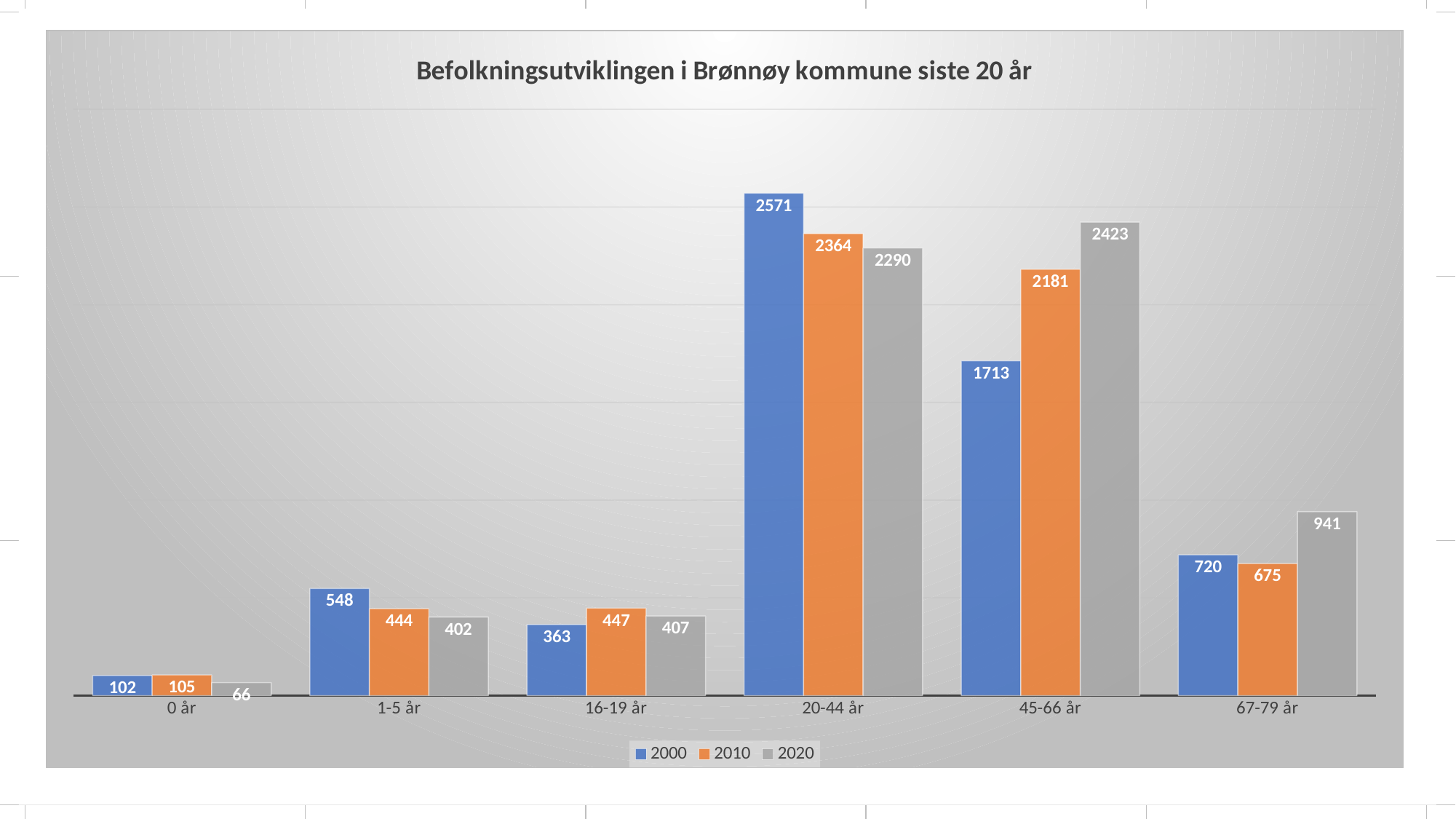
How many age categories are shown on the x axis? 6 What kind of chart is shown on the slide? Bar chart What is the value for the 2010 series in the 16-19 år category? 447 How many series does the legend list? 3 What is the title of the chart? Befolkningsutviklingen i Brønnøy kommune siste 20 år Does the 2000 series rise or fall from 20-44 år to 67-79 år? Fall What is the value for the 2000 series in the 20-44 år category? 2571 What is the value for the 2020 series in the 67-79 år category? 941 Which is larger in the 1-5 år category: the 2000 value or the 2010 value? 2000 Which category has the lowest value for the 2000 series? 0 år What is the difference between the 2000 and 2020 values in the 45-66 år category? 710 Which category has the highest value for the 2020 series? 45-66 år